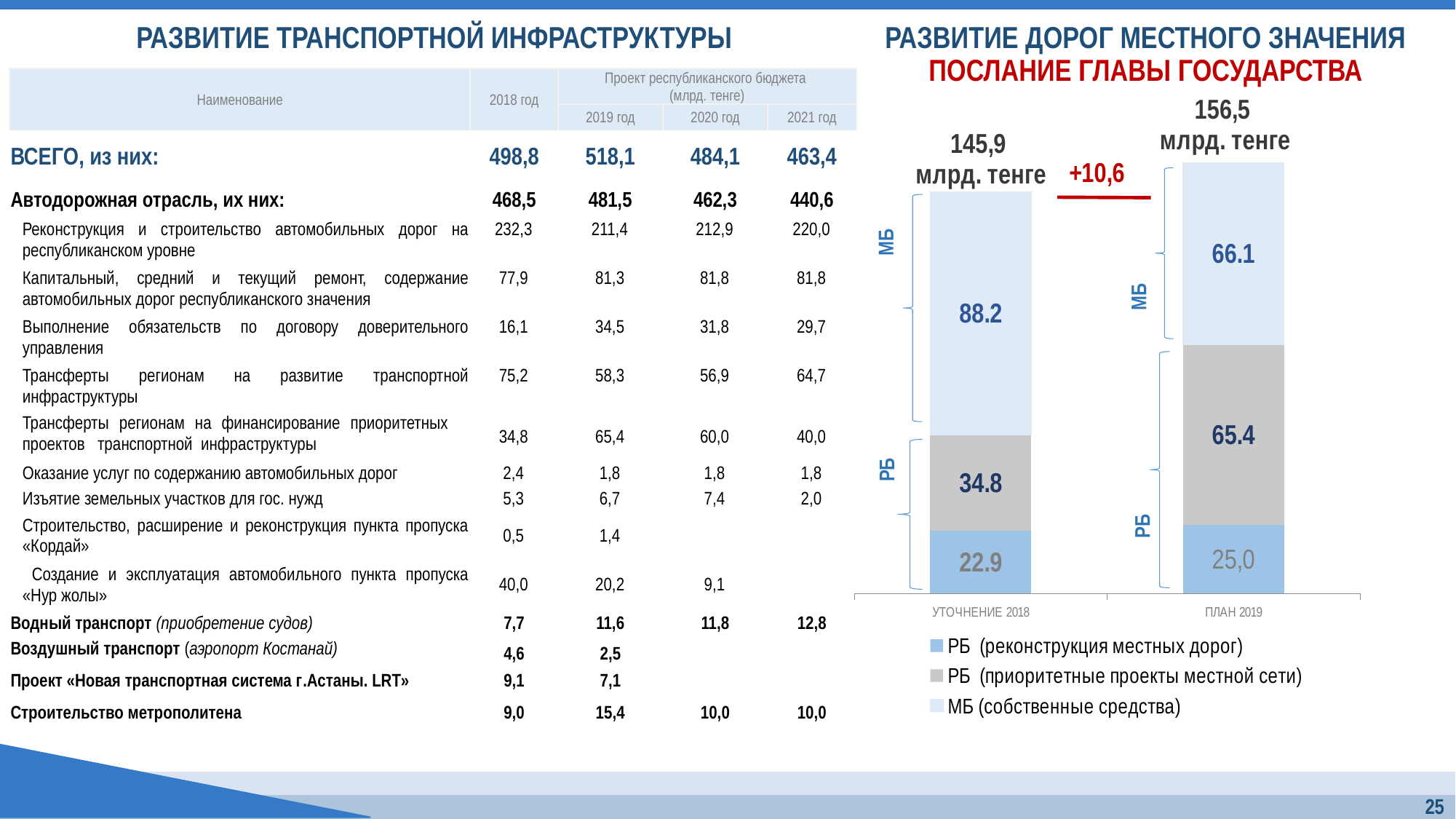
In the chart on the right, by how much does the total for ПЛАН 2019 exceed the total for УТОЧНЕНИЕ 2018? +10,6 What kind of chart is shown on the right side of the slide? stacked bar chart In the chart on the right, what is the total of the stacked bar for УТОЧНЕНИЕ 2018? 145,9 млрд. тенге In the chart on the right, what is the total of the stacked bar for ПЛАН 2019? 156,5 млрд. тенге In the chart on the right, what is the value of МБ (собственные средства) for ПЛАН 2019? 66.1 In the chart on the right, how many series does the legend list? 3 In the chart on the right, which series is the largest segment of the УТОЧНЕНИЕ 2018 bar? МБ (собственные средства) In the chart on the right, which is larger: РБ (приоритетные проекты местной сети) for УТОЧНЕНИЕ 2018 or for ПЛАН 2019? ПЛАН 2019 In the chart on the right, what is the value of РБ (реконструкция местных дорог) for УТОЧНЕНИЕ 2018? 22.9 In the chart on the right, how many categories are shown on the x axis? 2 In the chart on the right, what is the value of РБ (приоритетные проекты местной сети) for ПЛАН 2019? 65.4 In the chart on the right, what is the value of МБ (собственные средства) for УТОЧНЕНИЕ 2018? 88.2